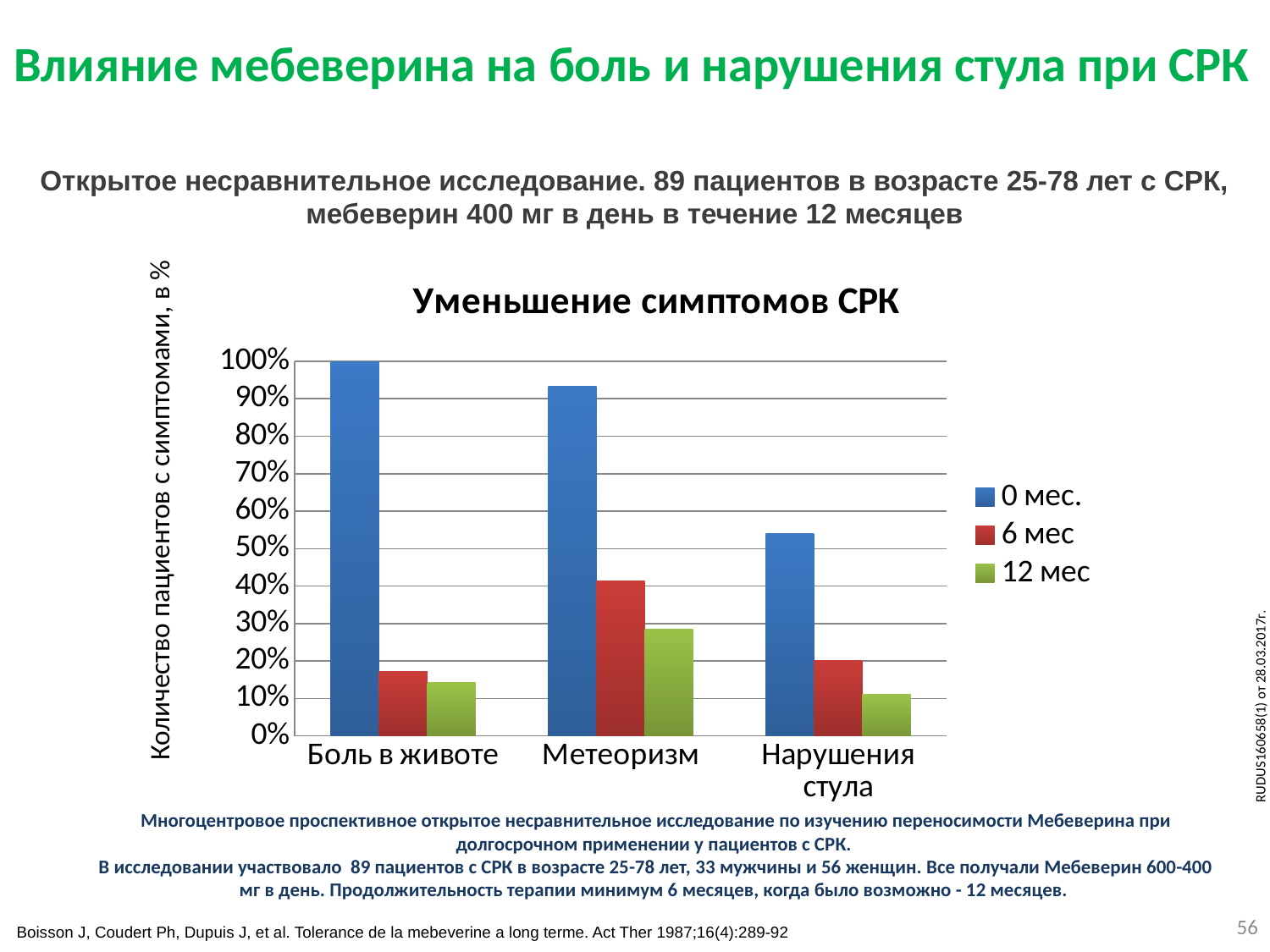
What is the value for Боль в животе at 0 мес.? 100% What kind of chart is shown on the slide? bar chart Which category has the highest value for the 0 мес. series? Боль в животе For Боль в животе, do the values rise or fall from 0 мес. to 12 мес? fall What is the title of the chart? Уменьшение симптомов СРК Which is larger for Метеоризм: the 6 мес value or the 12 мес value? 6 мес Is the value for Метеоризм at 0 мес. greater or less than 90%? greater Is the value for Нарушения стула at 0 мес. greater or less than 50%? greater How many categories are shown on the x axis of the chart? 3 Which category has the lowest value for the 0 мес. series? Нарушения стула How many series does the chart legend list? 3